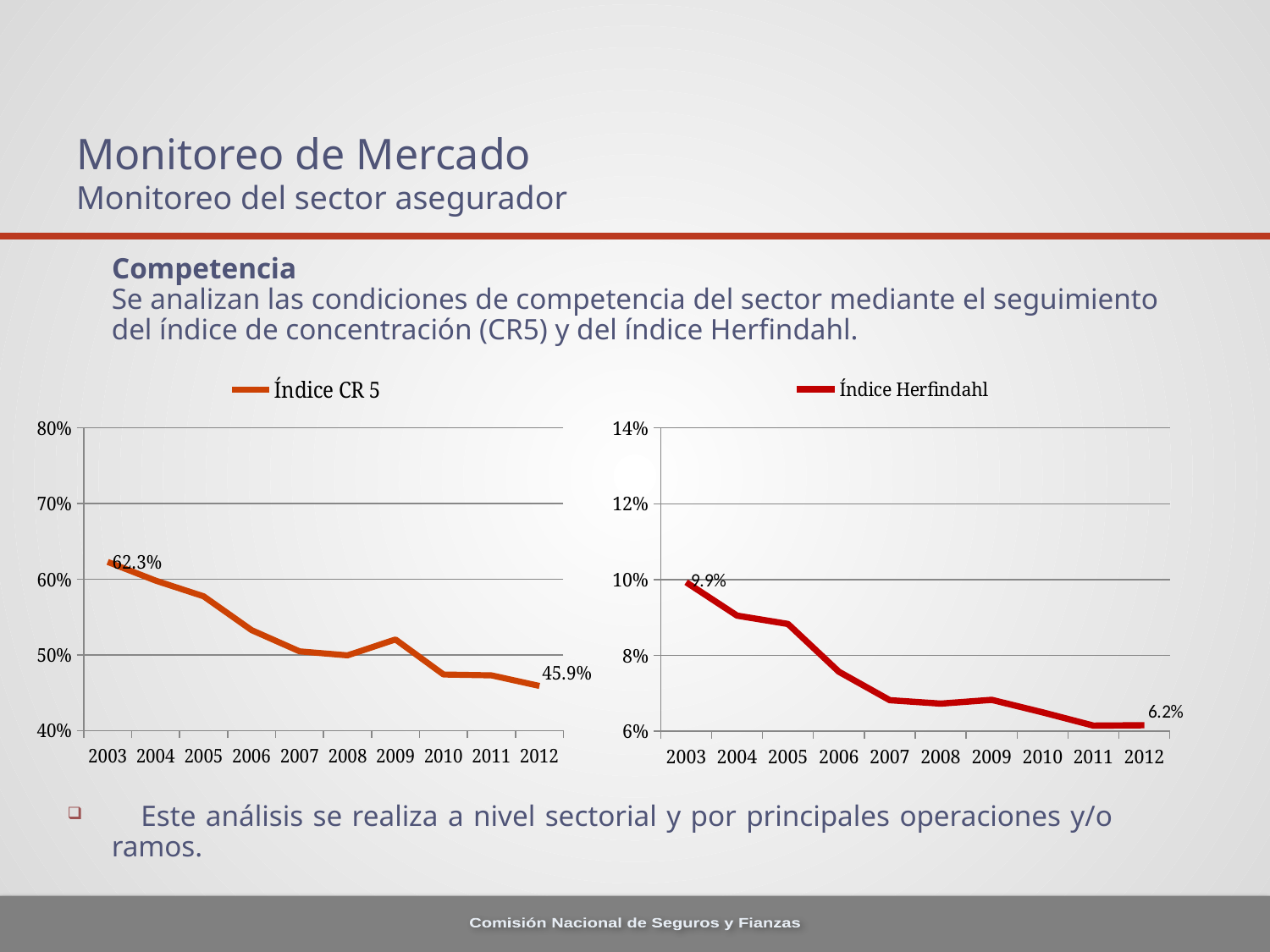
In the Índice Herfindahl chart, what is the value for 2012? 6.2% In the Índice CR 5 chart, what is the value for 2003? 62.3% In the Índice CR 5 chart, is the value for 2007 greater or less than 60%? less In the Índice Herfindahl chart, what is the difference between the 2003 and 2012 values? 3.7% In the Índice CR 5 chart, which year has the highest value? 2003 In the Índice CR 5 chart, what is the difference between the 2003 and 2012 values? 16.4% In the Índice Herfindahl chart, is the value for 2005 greater or less than 8%? greater What kind of chart is the Índice Herfindahl chart? Line chart In the Índice CR 5 chart, what is the value for 2012? 45.9% How many years are plotted on the x axis of the Índice CR 5 chart? 10 In the Índice Herfindahl chart, what is the value for 2003? 9.9%